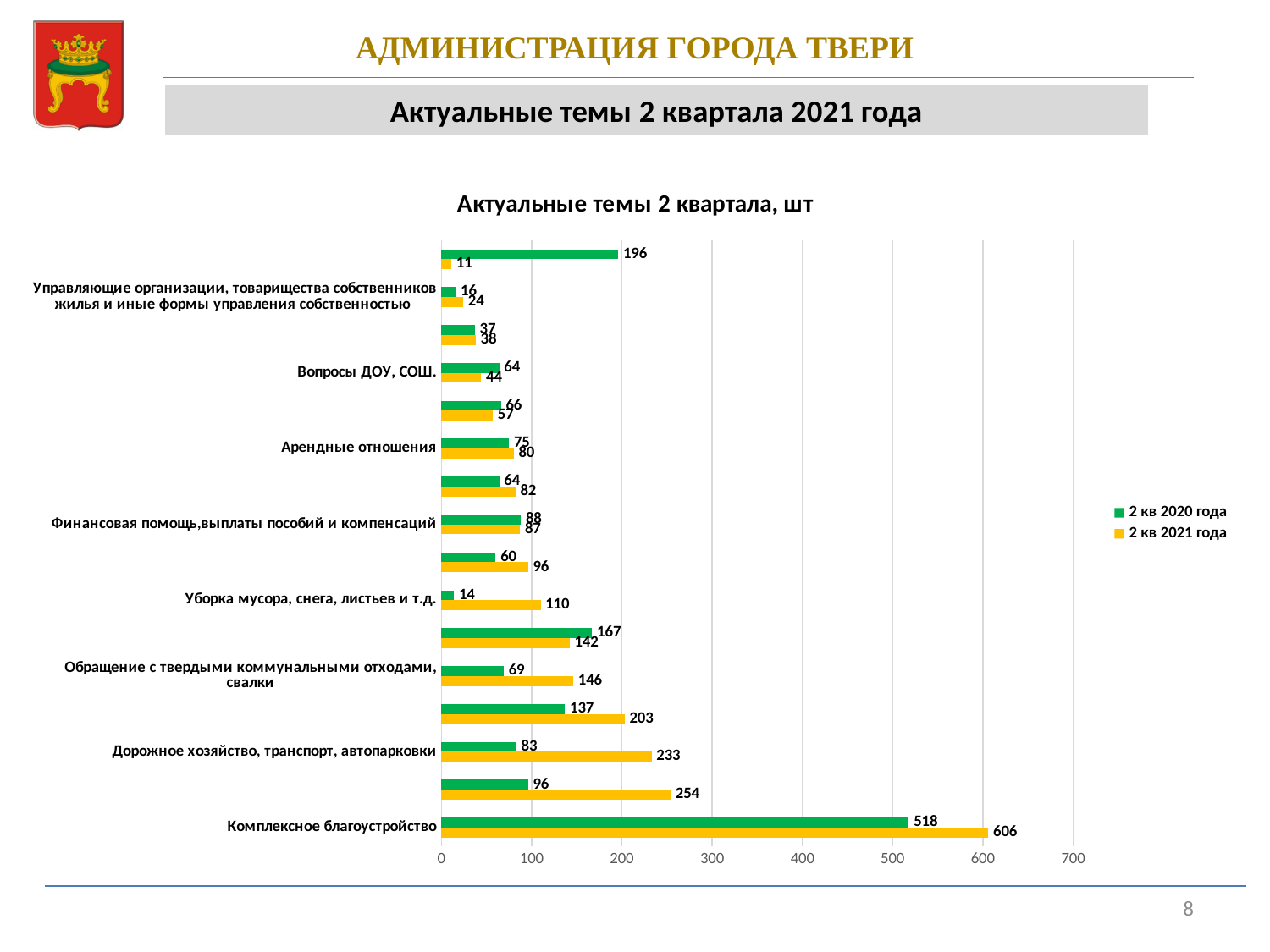
What is the value for Комплексное благоустройство in the 2 кв 2021 года series? 606 For Вопросы ДОУ, СОШ., which series has the larger value: 2 кв 2020 года or 2 кв 2021 года? 2 кв 2020 года Is the 2 кв 2021 года value for Обращение с твердыми коммунальными отходами, свалки greater or less than 100? greater What is the title of the chart? Актуальные темы 2 квартала, шт What is the value for Уборка мусора, снега, листьев и т.д. in the 2 кв 2020 года series? 14 What type of chart is shown on the slide? bar chart How many series does the legend list? 2 Which labeled category has the highest value in the 2 кв 2021 года series? Комплексное благоустройство What is the value for Дорожное хозяйство, транспорт, автопарковки in the 2 кв 2021 года series? 233 What is the value for Комплексное благоустройство in the 2 кв 2020 года series? 518 What is the difference between the 2 кв 2021 года and 2 кв 2020 года values for Комплексное благоустройство? 88 What is the difference between the 2 кв 2021 года and 2 кв 2020 года values for Дорожное хозяйство, транспорт, автопарковки? 150